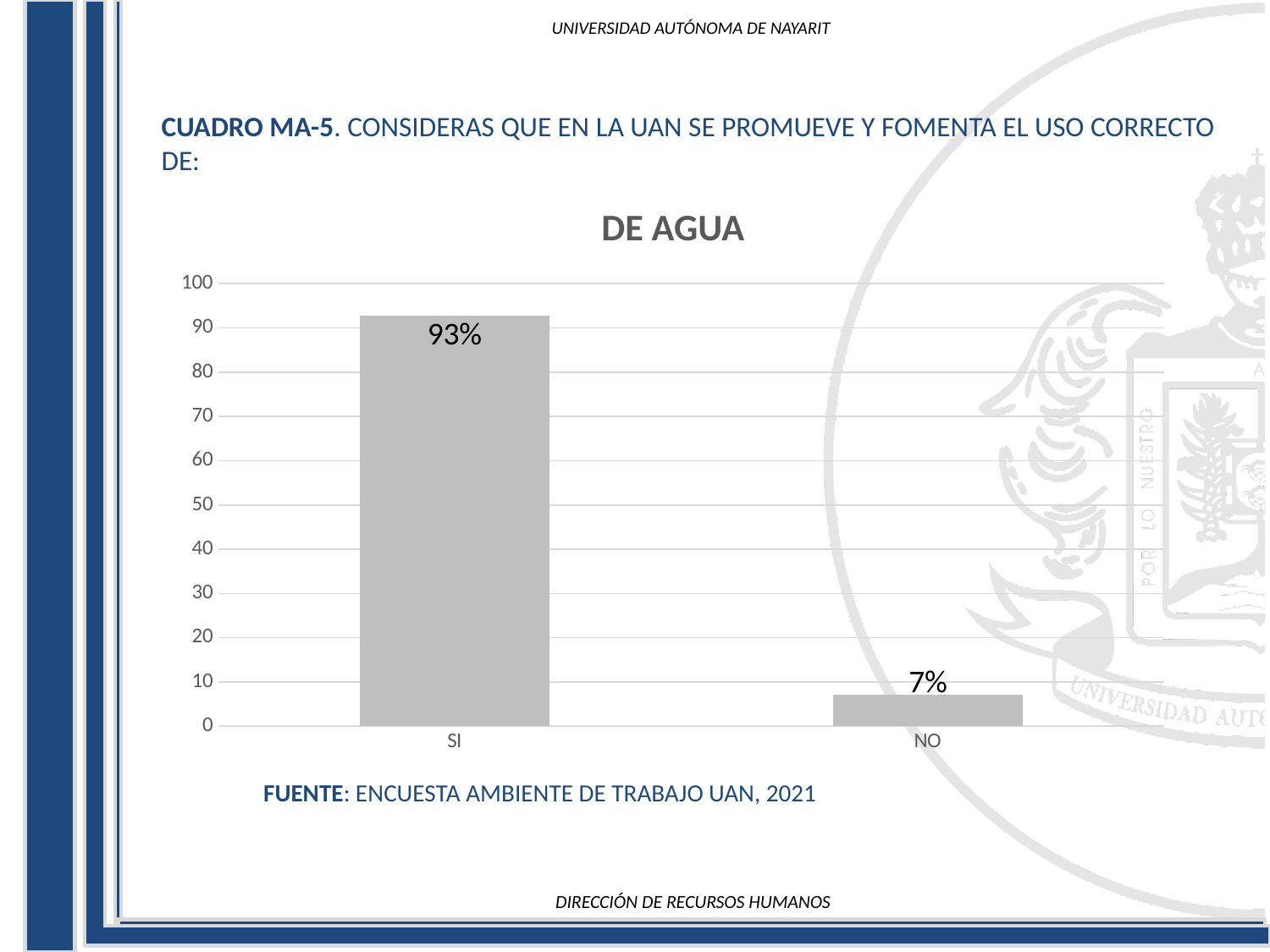
Is the value for SI greater or less than 90? greater What is the value for SI? 93% What kind of chart is shown? bar chart Is the value for NO greater or less than 10? less What is the difference between the values for SI and NO? 86% What is the title of the chart? DE AGUA Which is larger, the value for SI or the value for NO? SI What is the value for NO? 7% Which category has the lowest value? NO How many categories are shown on the x axis? 2 What is the source cited below the chart? ENCUESTA AMBIENTE DE TRABAJO UAN, 2021 Which category has the highest value? SI